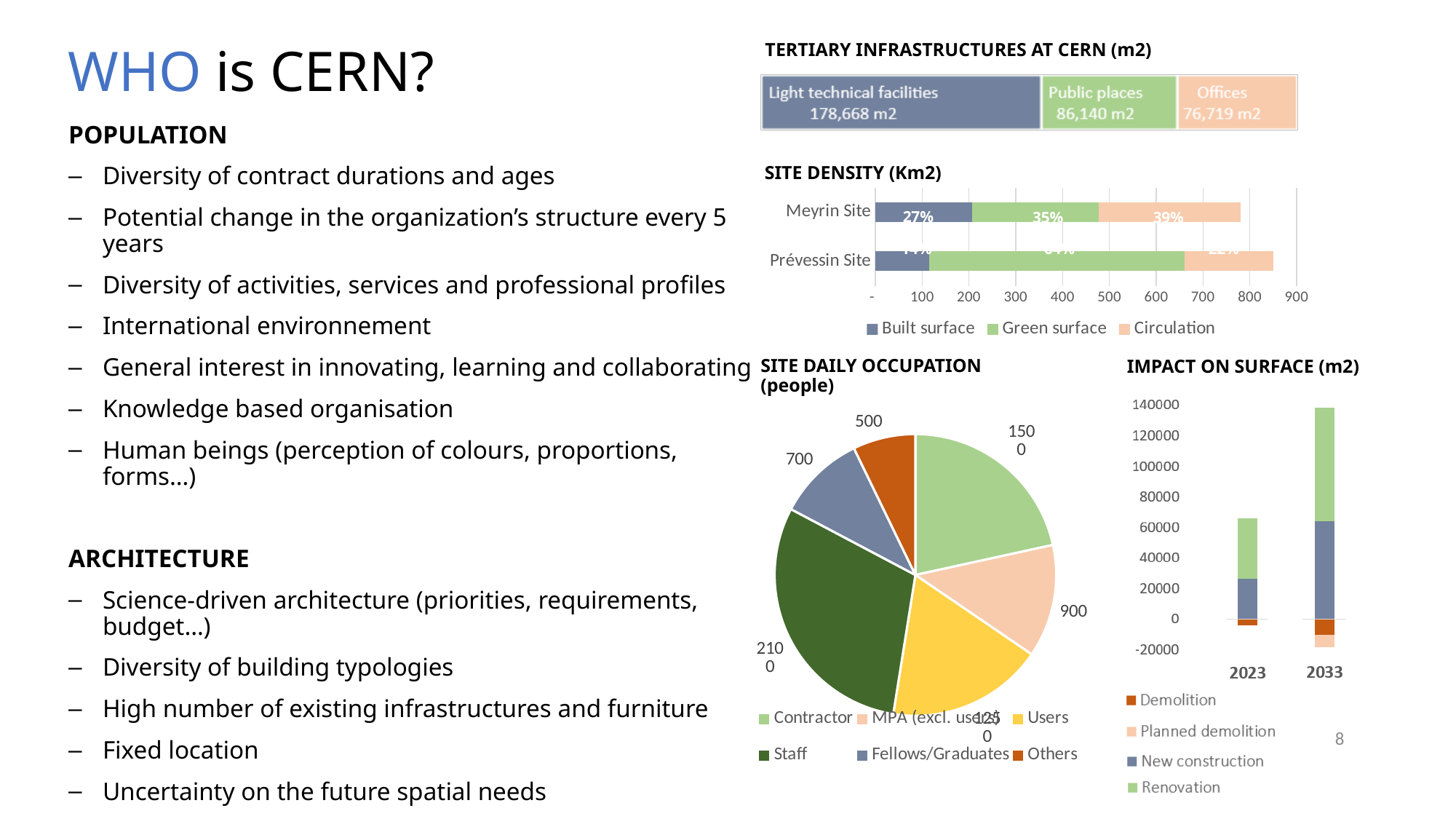
How many series does the legend of the SITE DENSITY (Km2) chart list? 3 In the SITE DENSITY (Km2) chart, what percentage is shown for Built surface at the Meyrin Site? 27% In the SITE DAILY OCCUPATION (people) chart, how many people are Staff? 2100 In the SITE DAILY OCCUPATION (people) chart, which category has the smallest number of people? Others How many series does the legend of the IMPACT ON SURFACE (m2) chart list? 4 In the TERTIARY INFRASTRUCTURES AT CERN (m2) chart, what is the difference between Public places and Offices? 9,421 m2 In the SITE DENSITY (Km2) chart, what percentage is shown for Circulation at the Meyrin Site? 39% In the IMPACT ON SURFACE (m2) chart, is the top of the 2033 stacked bar greater or less than 120000? greater In the TERTIARY INFRASTRUCTURES AT CERN (m2) chart, what is the value for Light technical facilities? 178,668 m2 In the SITE DAILY OCCUPATION (people) chart, what is the difference between Contractor and Fellows/Graduates? 800 What kind of chart is the SITE DAILY OCCUPATION (people) chart? Pie chart In the TERTIARY INFRASTRUCTURES AT CERN (m2) chart, which category has the largest surface? Light technical facilities